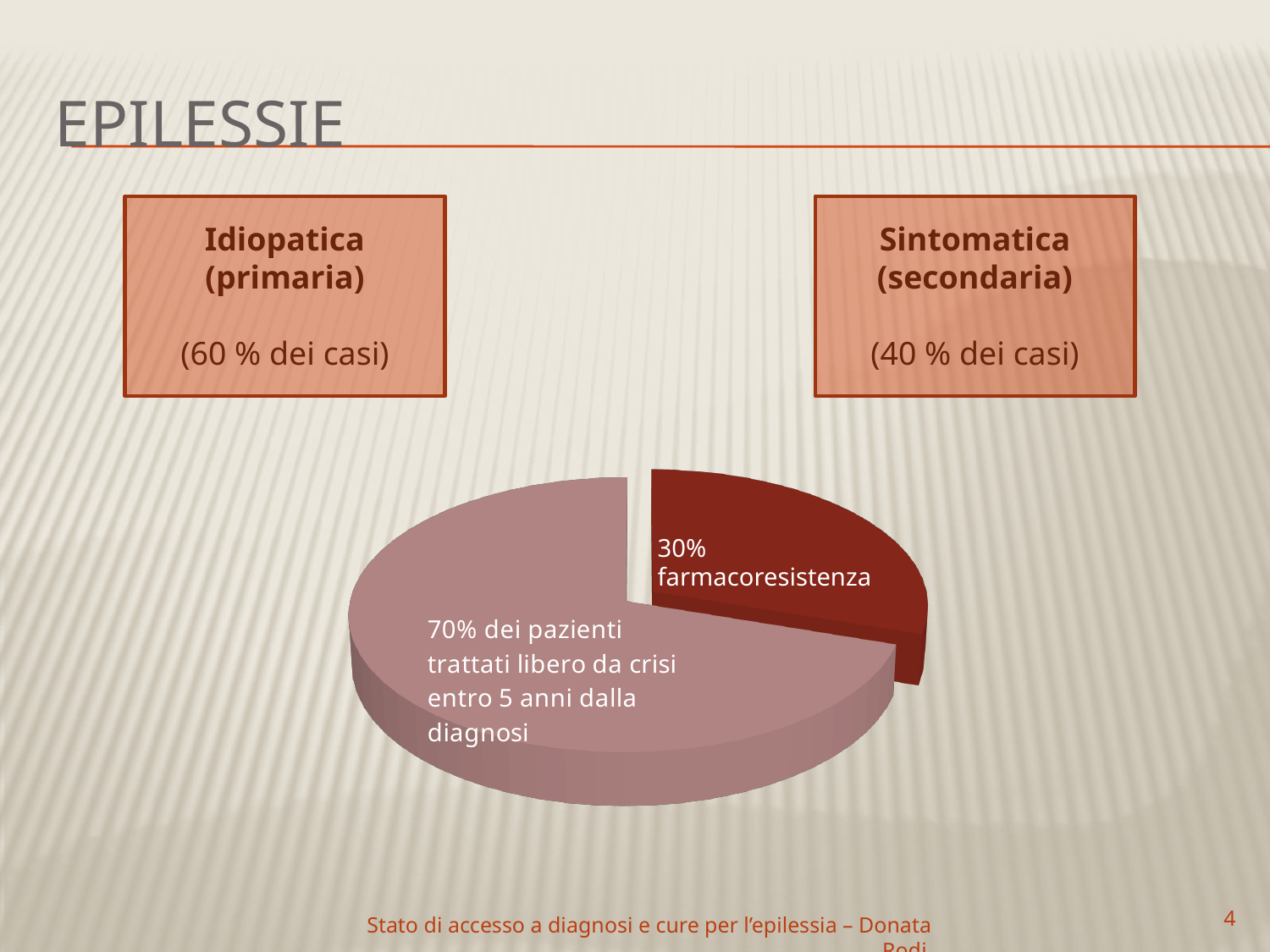
What share of the pie is labelled "dei pazienti trattati libero da crisi entro 5 anni dalla diagnosi"? 70% What kind of chart is shown on the slide? pie chart What is the total of the two slices in the pie chart? 100% Which slice of the pie chart is pulled out (exploded) from the rest of the pie? 30% farmacoresistenza What colour is the farmacoresistenza slice of the pie chart? dark red Which slice of the pie chart is the smallest? 30% farmacoresistenza Which is larger: the farmacoresistenza slice or the slice for patients free from seizures within 5 years of diagnosis? the slice for patients free from seizures within 5 years of diagnosis (70%) Which slice of the pie chart is the largest? 70% dei pazienti trattati libero da crisi entro 5 anni dalla diagnosi What is the difference in percentage points between the two slices of the pie chart? 40 How many slices does the pie chart have? 2 What share of the pie is labelled "farmacoresistenza"? 30%